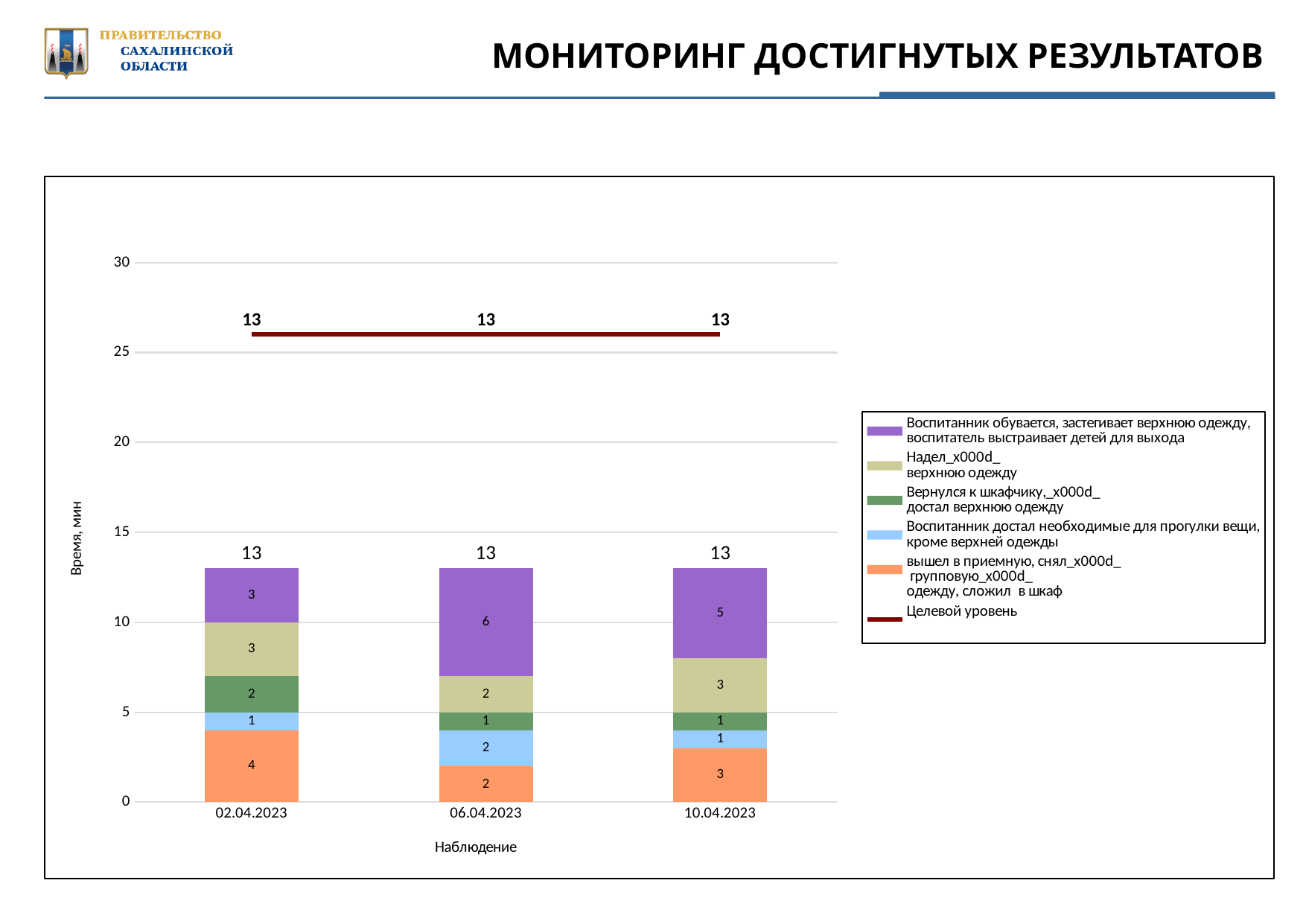
Do the bar totals rise, fall, or stay the same across the three dates? Stay the same What is the total of the stacked bar for 10.04.2023? 13 What is the value of the segment 'вышел в приемную, снял групповую одежду, сложил в шкаф' for 02.04.2023? 4 What kind of chart is shown on the slide? Stacked bar chart with a target-level line What is the value of the segment 'Воспитанник обувается, застегивает верхнюю одежду, воспитатель выстраивает детей для выхода' for 06.04.2023? 6 How many entries does the legend list? 6 What value is labelled on the 'Целевой уровень' line? 13 What is the difference between the 'Воспитанник обувается, застегивает верхнюю одежду, воспитатель выстраивает детей для выхода' values for 06.04.2023 and 02.04.2023? 3 What is the title of the y axis? Время, мин How many observation dates are shown on the x axis? 3 Which date has the larger value for 'вышел в приемную, снял групповую одежду, сложил в шкаф': 02.04.2023 or 06.04.2023? 02.04.2023 On which date is the segment 'Воспитанник обувается, застегивает верхнюю одежду, воспитатель выстраивает детей для выхода' the largest? 06.04.2023